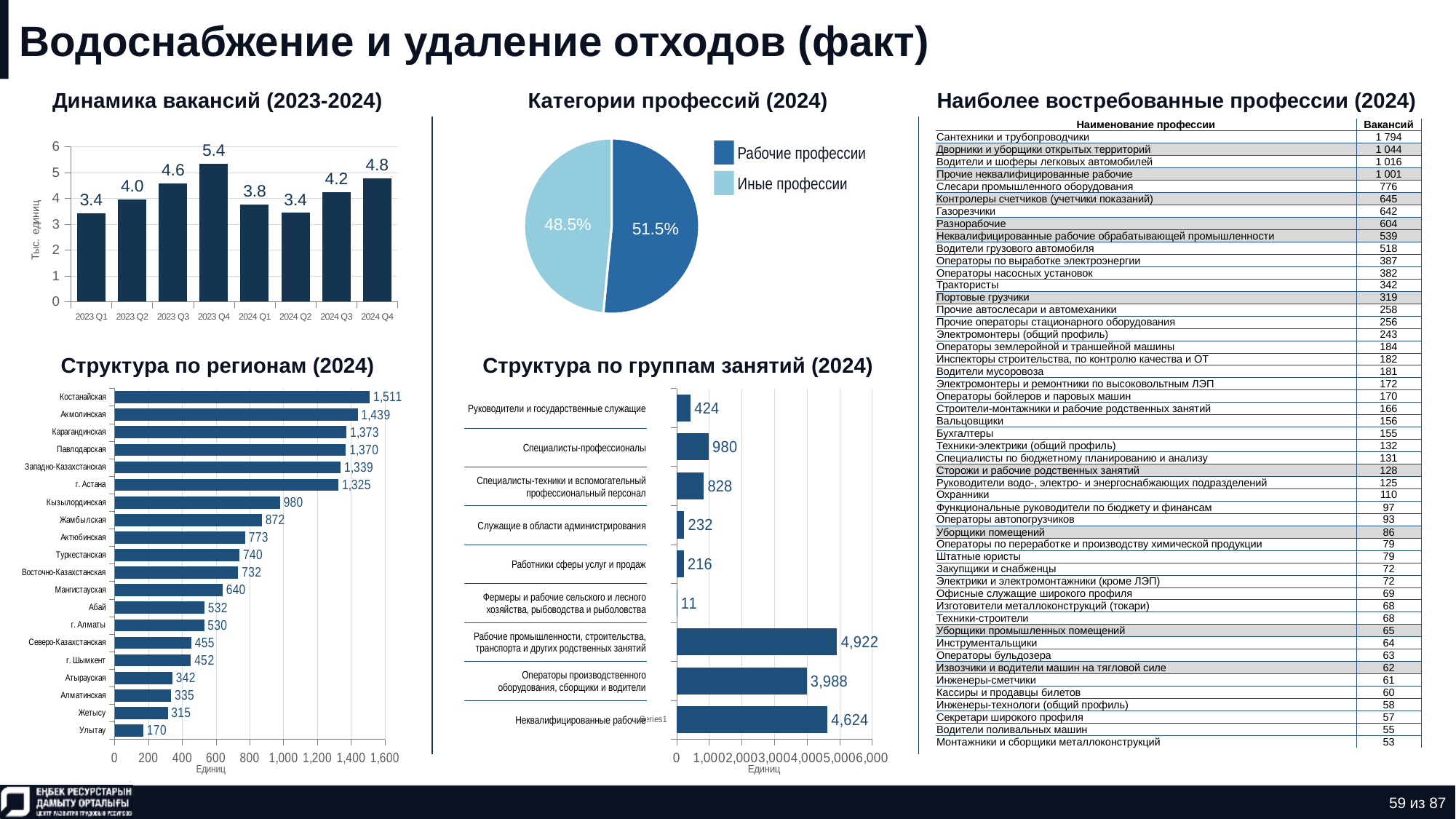
In the chart 'Динамика вакансий (2023-2024)', which quarter has the highest value? 2023 Q4 In the chart 'Структура по регионам (2024)', which region has the highest value? Костанайская What kind of chart is 'Категории профессий (2024)'? Pie chart In the chart 'Динамика вакансий (2023-2024)', what is the difference between 2024 Q4 and 2024 Q1? 1.0 In the chart 'Структура по регионам (2024)', what is the difference between Костанайская and Акмолинская? 72 In the chart 'Динамика вакансий (2023-2024)', how many quarters are plotted? 8 In the chart 'Структура по регионам (2024)', what is the value for Кызылординская? 980 In the chart 'Структура по группам занятий (2024)', what is the value for 'Операторы производственного оборудования, сборщики и водители'? 3,988 In the chart 'Структура по группам занятий (2024)', which is larger: 'Специалисты-профессионалы' or 'Специалисты-техники и вспомогательный профессиональный персонал'? Специалисты-профессионалы In the chart 'Категории профессий (2024)', what share of the pie is 'Рабочие профессии'? 51.5% In the chart 'Динамика вакансий (2023-2024)', what is the value for 2023 Q4? 5.4 In the chart 'Структура по регионам (2024)', which region has the lowest value? Улытау